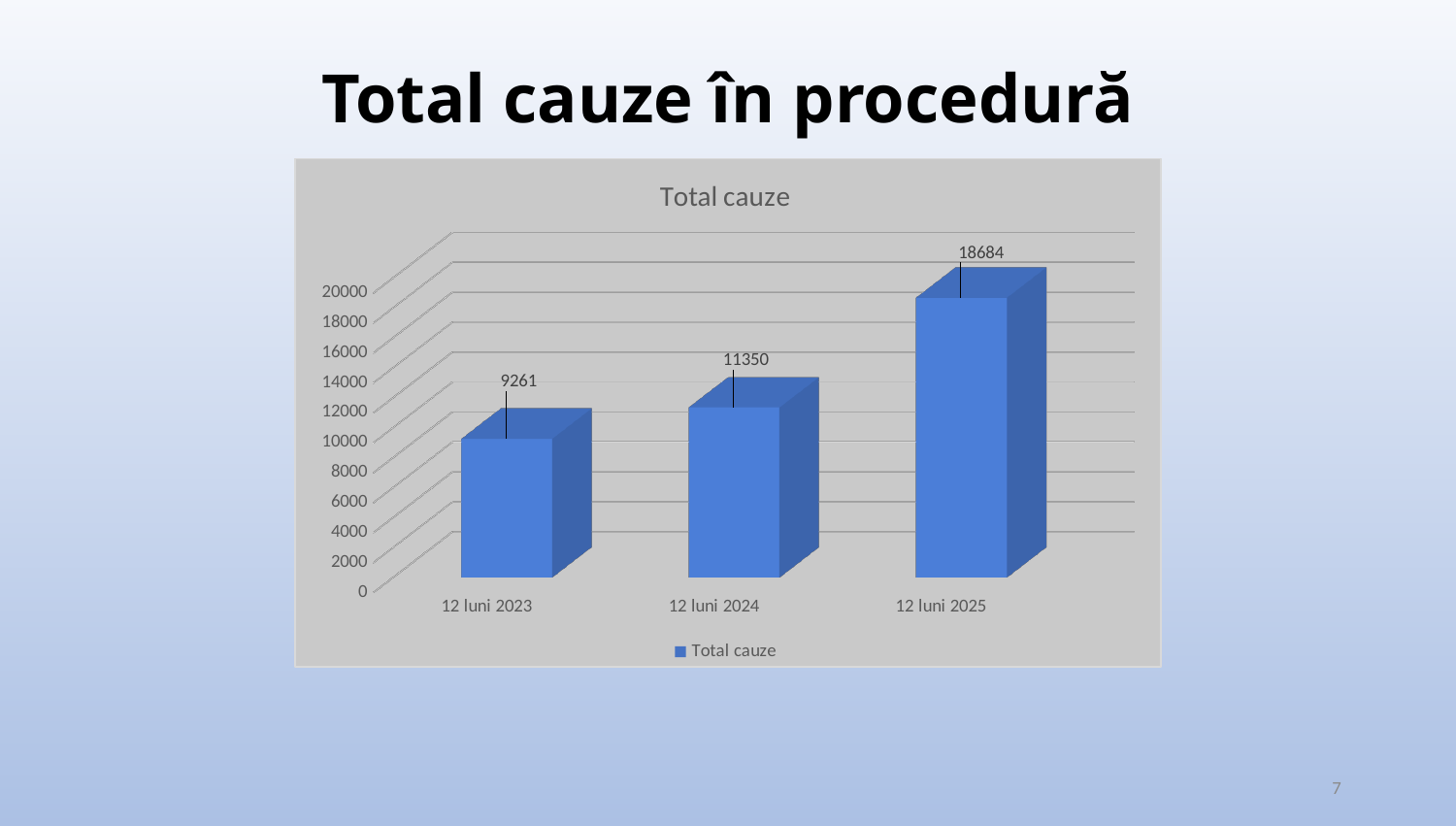
Which is larger, the value for 12 luni 2024 or the value for 12 luni 2023? 12 luni 2024 Do the values rise or fall from 12 luni 2023 to 12 luni 2025? rise What kind of chart is shown? bar chart Which category has the lowest value? 12 luni 2023 How many categories are shown on the x axis? 3 How many series does the legend list? 1 What is the value for 12 luni 2025? 18684 What is the value for 12 luni 2024? 11350 What is the difference between the values for 12 luni 2024 and 12 luni 2023? 2089 What is the difference between the values for 12 luni 2025 and 12 luni 2024? 7334 Which category has the highest value? 12 luni 2025 What is the value for 12 luni 2023? 9261